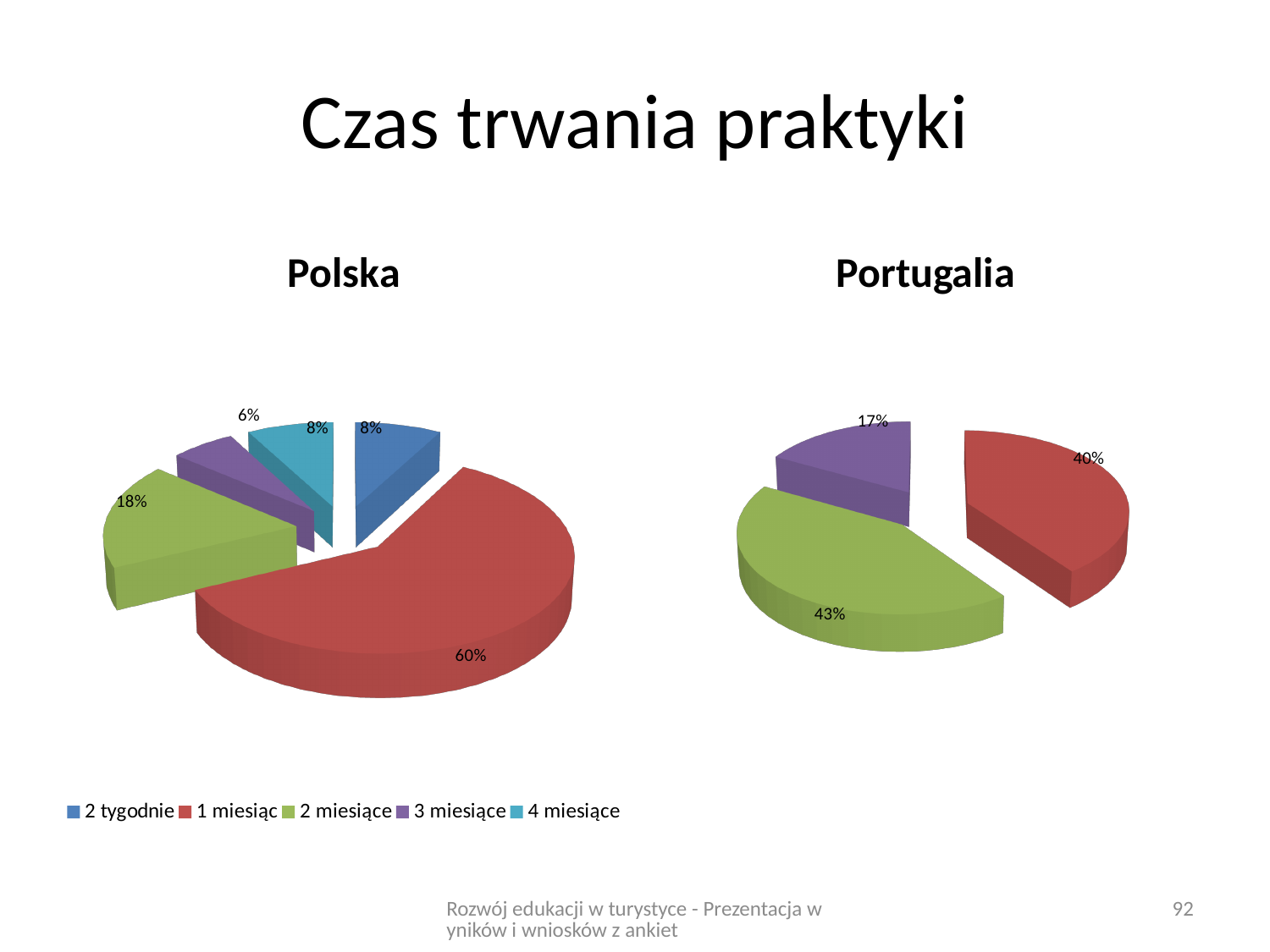
In the Portugalia chart, what is the difference between the 2 miesiące and 1 miesiąc shares? 3% In the Portugalia chart, which category has the smallest slice? 3 miesiące In the Polska chart, what share is labelled for the 3 miesiące slice? 6% In the Polska chart, what share is labelled for the 2 miesiące slice? 18% In the Polska chart, what share is labelled for the 1 miesiąc slice? 60% In the Polska chart, which category has the largest slice? 1 miesiąc How many categories does the legend list? 5 In the Portugalia chart, what share is labelled for the 2 miesiące slice? 43% In the Polska chart, which category has the smallest slice? 3 miesiące In the Portugalia chart, what share is labelled for the 3 miesiące slice? 17% How many slices does the Portugalia chart have? 3 In the Polska chart, what is the difference between the 1 miesiąc and 2 miesiące shares? 42%